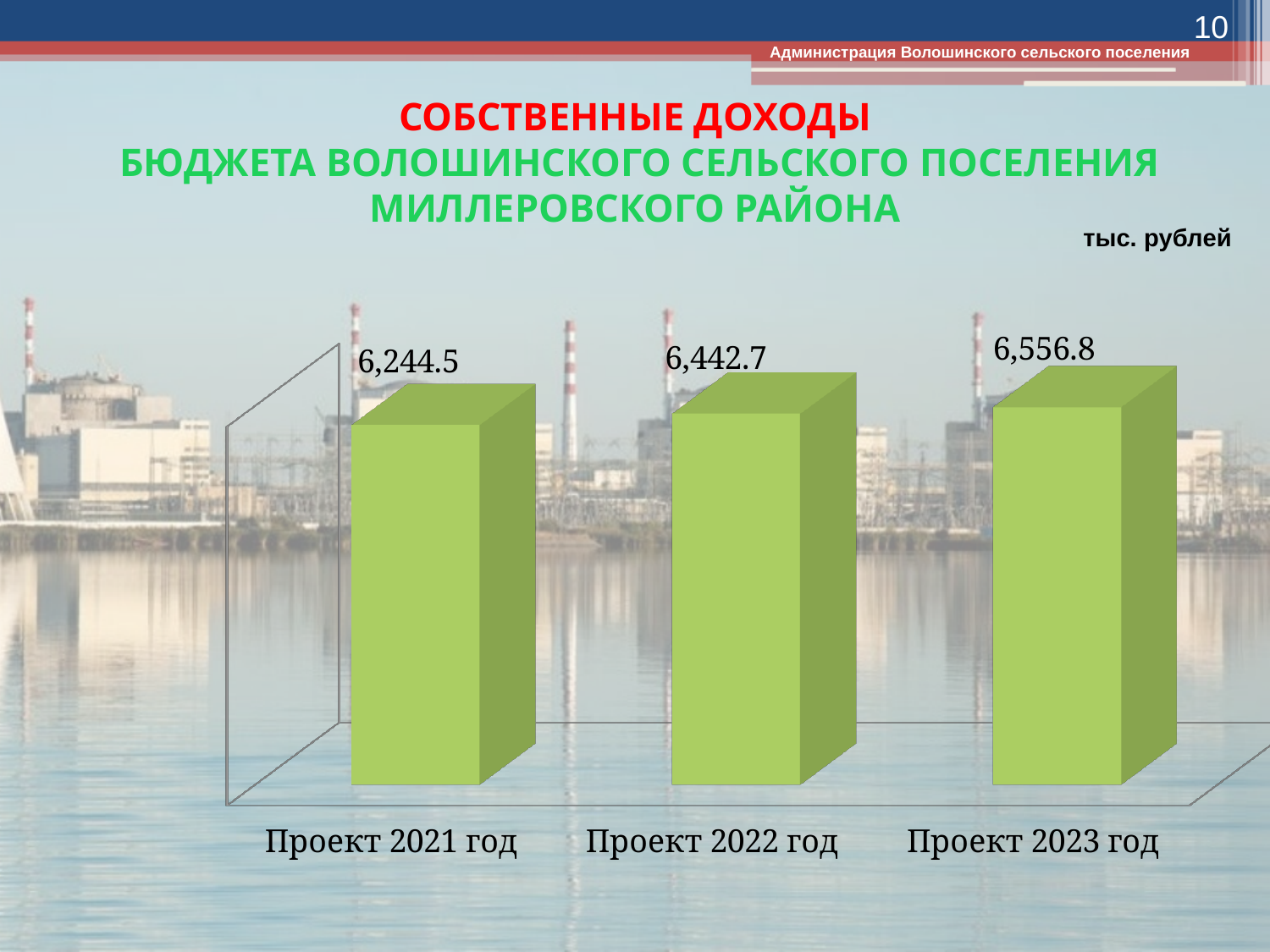
Do the values rise or fall from Проект 2021 год to Проект 2023 год? Rise How many categories are shown in the chart? 3 What is the value for Проект 2023 год? 6,556.8 Which is larger, the value for Проект 2022 год or Проект 2023 год? Проект 2023 год Which category has the lowest value? Проект 2021 год Which category has the highest value? Проект 2023 год What is the difference between the values for Проект 2023 год and Проект 2021 год? 312.3 What is the value for Проект 2022 год? 6,442.7 What kind of chart is shown on the slide? Bar chart In what units are the chart values given? тыс. рублей What is the value for Проект 2021 год? 6,244.5 What is the difference between the values for Проект 2022 год and Проект 2021 год? 198.2